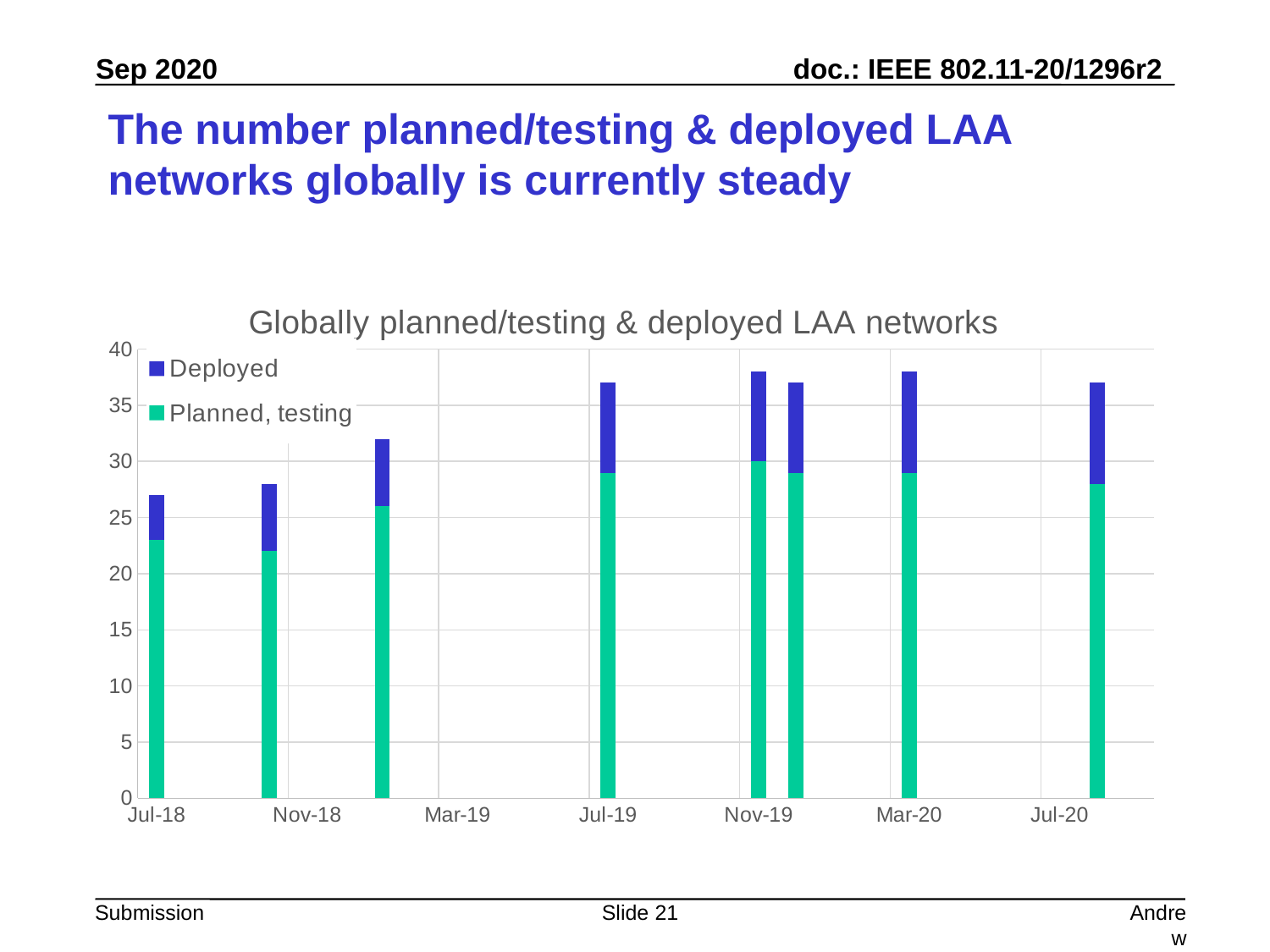
How many bars are plotted in the chart? 8 Which bar has the larger total, the one at Jul-18 or the one at Jul-19? Jul-19 Is the total height of the bar at Jul-18 greater or less than 30? less Do the total bar heights generally rise or fall from Jul-18 to Jul-19? rise How many series does the legend list? 2 What kind of chart is shown on the slide? stacked bar chart Is the 'Planned, testing' value for the bar at Jul-18 greater or less than 20? greater Is the 'Planned, testing' value for the bar at Mar-20 greater or less than 25? greater Which two series are listed in the chart legend? Deployed; Planned, testing What is the title of the chart? Globally planned/testing & deployed LAA networks